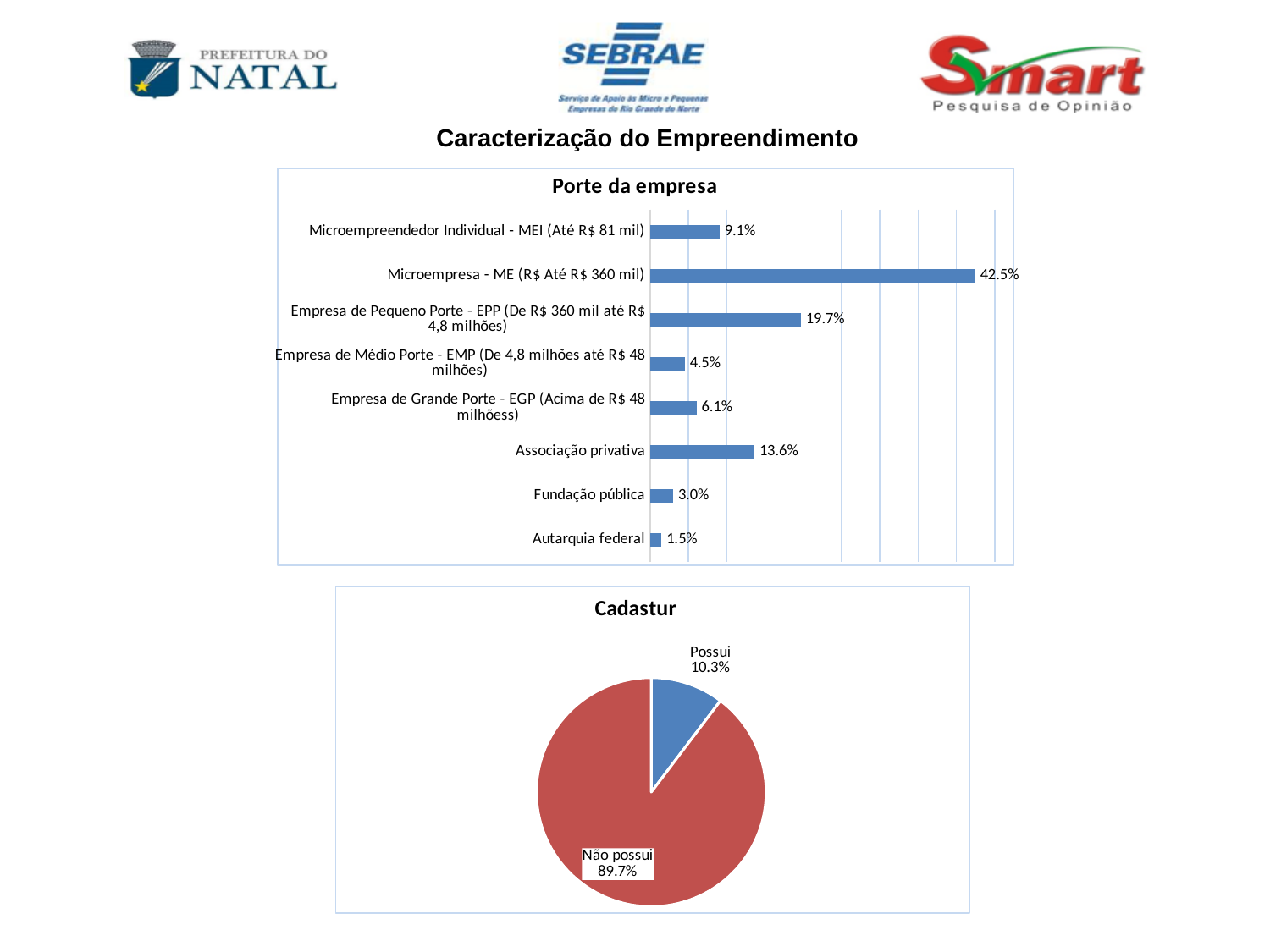
In the 'Porte da empresa' chart, what is the value for Fundação pública? 3.0% In the 'Porte da empresa' chart, which is larger: the value for Empresa de Grande Porte - EGP or Empresa de Médio Porte - EMP? Empresa de Grande Porte - EGP In the 'Porte da empresa' chart, which category has the lowest value? Autarquia federal In the 'Cadastur' chart, what is the value for 'Possui'? 10.3% In the 'Porte da empresa' chart, what is the value for Microempresa - ME (R$ Até R$ 360 mil)? 42.5% In the 'Cadastur' chart, what share of the pie is 'Não possui'? 89.7% What kind of chart is 'Porte da empresa'? Bar chart What kind of chart is 'Cadastur'? Pie chart In the 'Porte da empresa' chart, what is the value for Associação privativa? 13.6% In the 'Porte da empresa' chart, what is the difference between the values for Microempresa - ME and Empresa de Pequeno Porte - EPP? 22.8% How many categories are shown in the 'Porte da empresa' chart? 8 In the 'Porte da empresa' chart, which category has the highest value? Microempresa - ME (R$ Até R$ 360 mil)